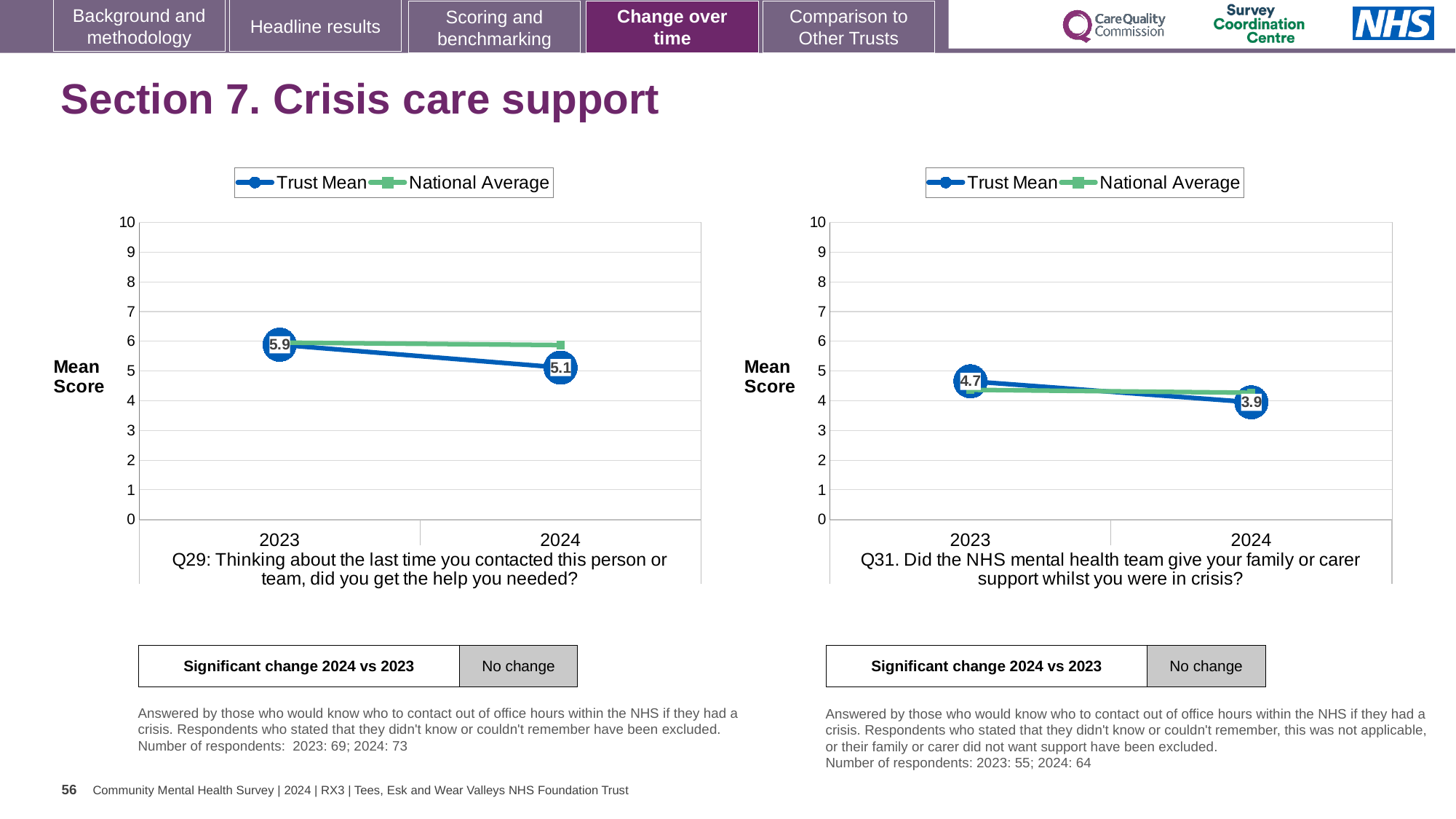
In the Q29 chart, which is larger in 2024, the Trust Mean or the National Average? National Average In the Q29 chart, is the National Average for 2024 greater or less than 5? greater How many series does the legend of the Q31 chart list? 2 In the Q29 chart, what is the Trust Mean for 2024? 5.1 In the Q29 chart, does the Trust Mean rise or fall from 2023 to 2024? fall In the Q29 chart, what is the Trust Mean for 2023? 5.9 What kind of chart is the Q29 chart? line chart In the Q31 chart, what is the Trust Mean for 2024? 3.9 In the Q31 chart, what is the difference between the Trust Mean in 2023 and 2024? 0.8 In the Q29 chart, by how much did the Trust Mean change from 2023 to 2024? 0.8 In the Q31 chart, what is the Trust Mean for 2023? 4.7 In the Q31 chart, does the Trust Mean rise or fall from 2023 to 2024? fall